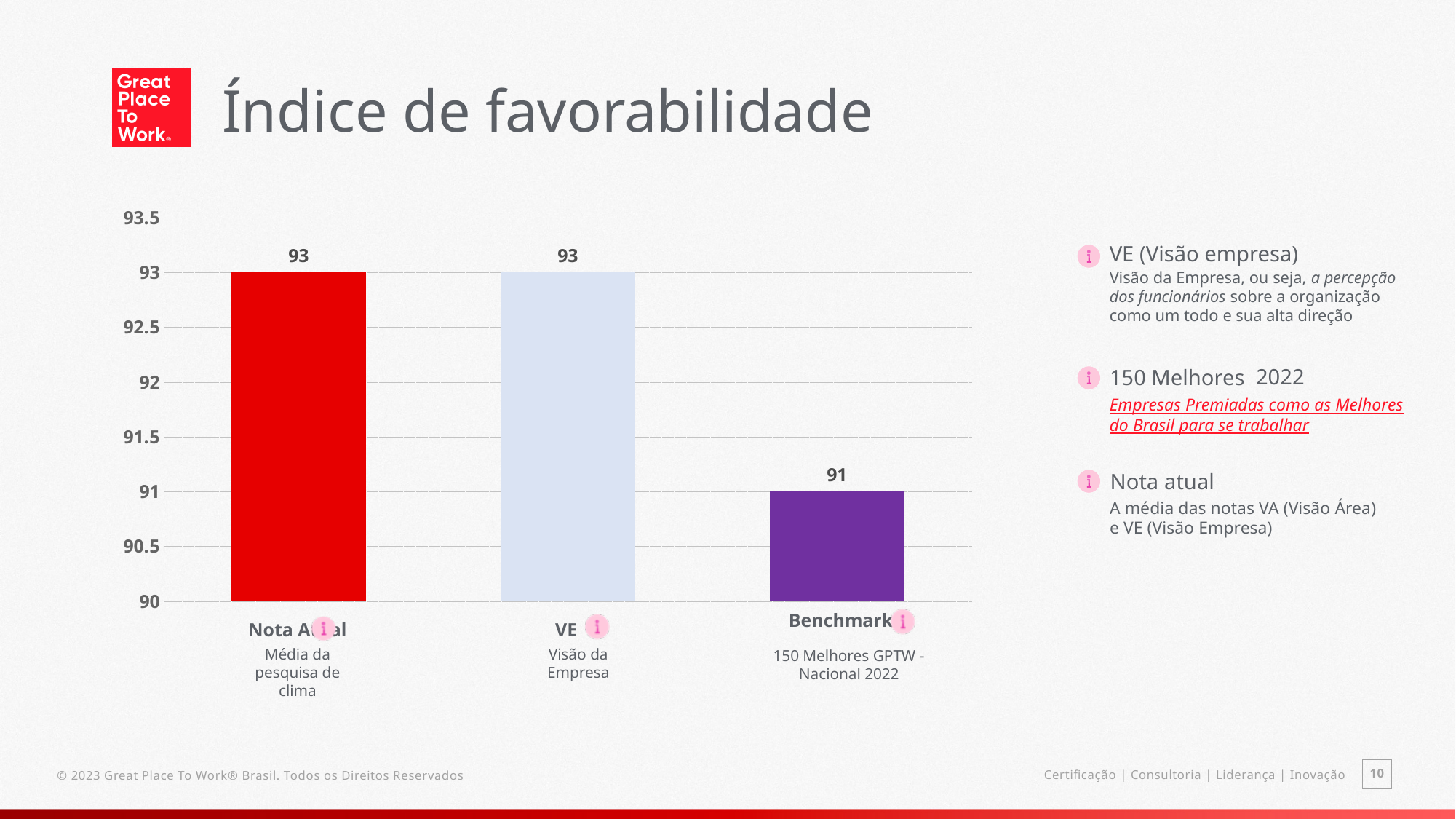
How many categories are shown in the chart? 3 What is the value for Nota Atual? 93 Is the value for Nota Atual greater or less than 92.5? greater What is the title of the slide containing the chart? Índice de favorabilidade What is the value for VE? 93 What kind of chart is shown on the slide? bar chart What is the value for Benchmark? 91 Which is larger, the value for VE or the value for Benchmark? VE Which category has the lowest value? Benchmark Is the value for Benchmark greater or less than 92? less What is the difference between the Nota Atual value and the Benchmark value? 2 What colour is the Benchmark bar? purple